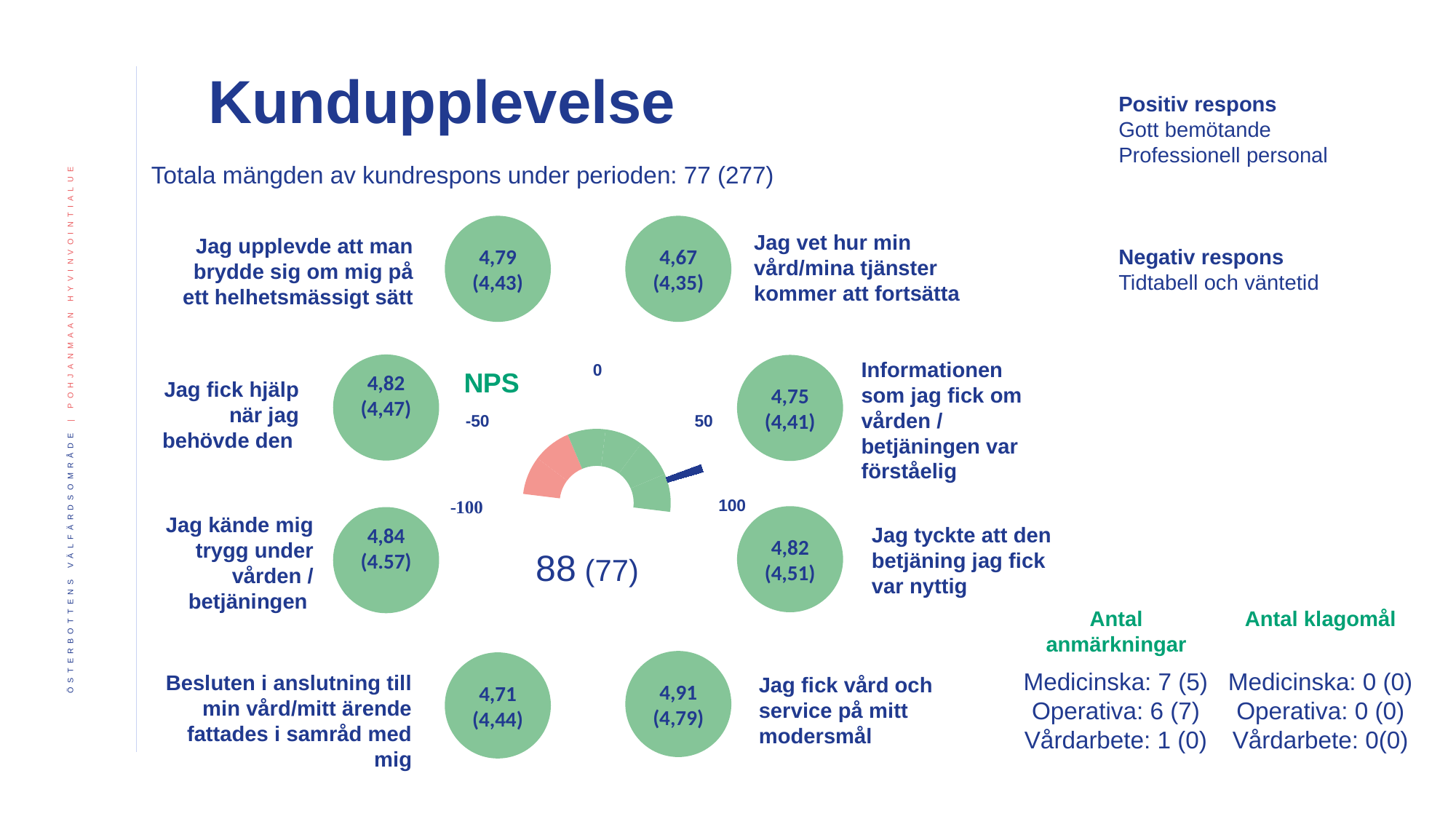
What is the highest value labelled on the NPS gauge scale? 100 Is the current NPS value shown on the gauge greater or less than 50? greater What NPS value is displayed below the gauge chart? 88 (77) Which statement has the highest current score among the green circles? Jag fick vård och service på mitt modersmål What score is shown in the circle for 'Jag fick vård och service på mitt modersmål'? 4,91 (4,79) What is the lowest value labelled on the NPS gauge scale? -100 How many tick labels are printed around the NPS gauge? 5 Which statement has the lowest current score among the green circles? Jag vet hur min vård/mina tjänster kommer att fortsätta What kind of chart is used to show the NPS score? gauge chart What is the title shown next to the gauge chart? NPS What score is shown in the circle for 'Jag fick hjälp när jag behövde den'? 4,82 (4,47) What colour is the lowest segment of the gauge arc, near -100? red